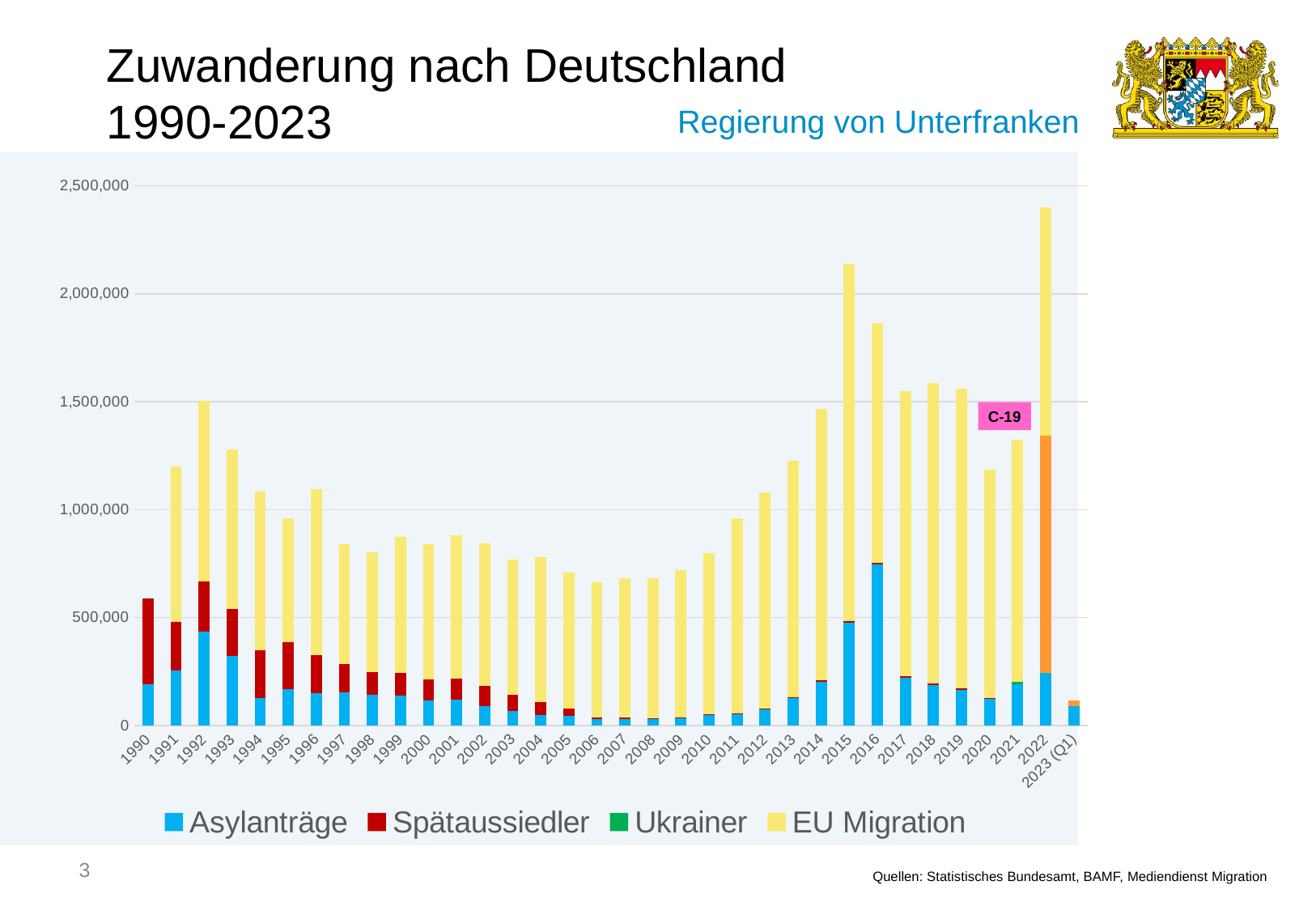
Is the total for 2006 greater or less than 1,000,000? less Which category has the shortest total bar? 2023 (Q1) What kind of chart is shown on the slide? stacked bar chart Which year has the larger total bar, 2015 or 2016? 2015 How many year categories are shown on the x axis? 34 Which year has the tallest total bar? 2022 Is the total for 1992 greater or less than 1,000,000? greater Which series is shown in blue in the legend? Asylanträge Is the total for 2015 greater or less than 2,000,000? greater Do the total bars generally rise or fall from 2006 to 2015? rise How many series does the legend list? 4